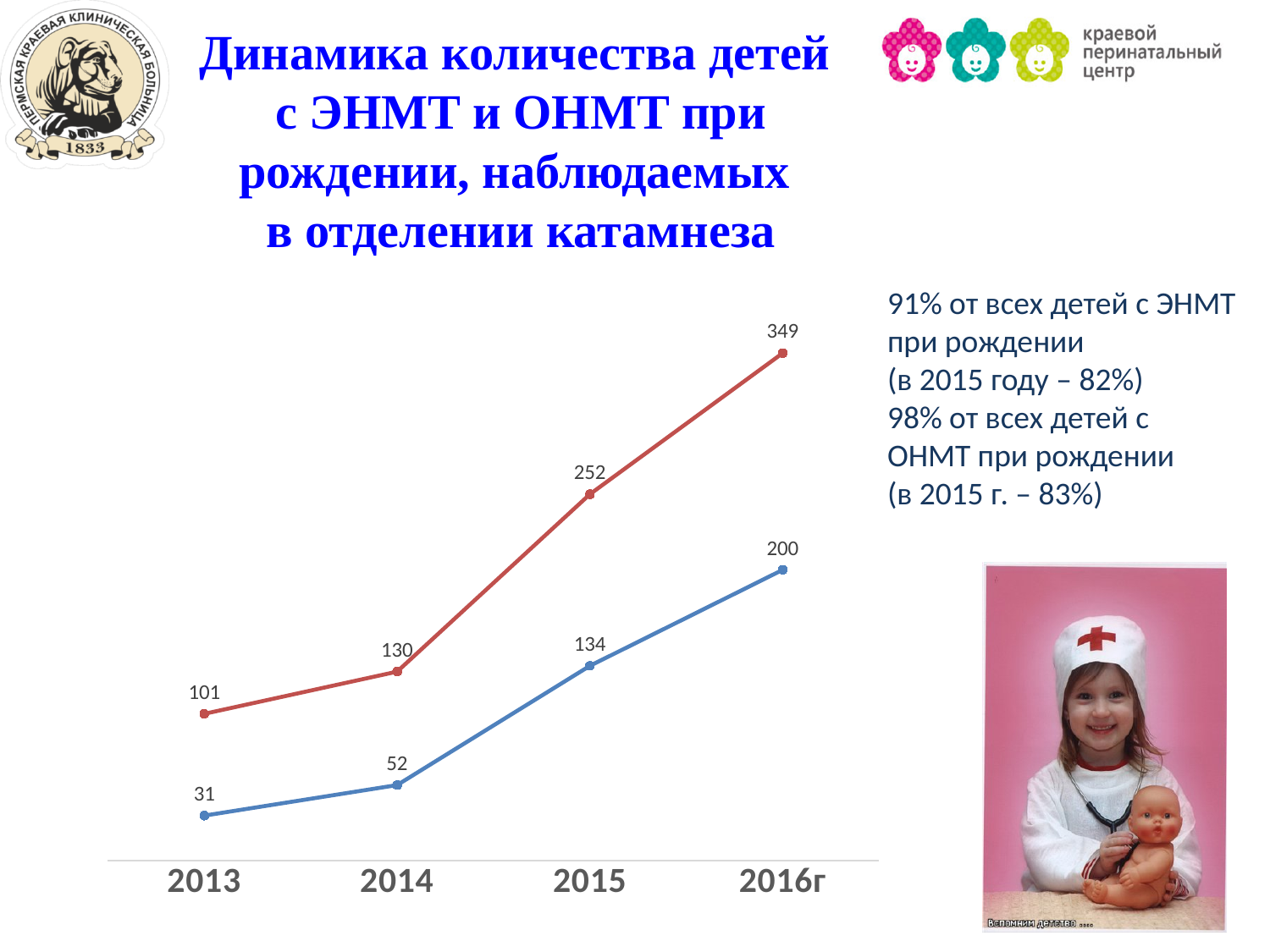
What is the value of the red line in 2016г? 349 By how much did the red line value increase from 2013 to 2016г? 248 What is the value of the blue line in 2013? 31 What is the value of the red line in 2015? 252 What is the difference between the red line and the blue line values in 2015? 118 What is the value of the blue line in 2014? 52 Which is larger in 2014: the red line value or the blue line value? the red line value How many years are shown on the x axis of the chart? 4 What type of chart is shown on the slide? line chart In which year does the red line have its lowest value? 2013 Do the values of the blue line rise or fall from 2013 to 2016г? rise In which year does the blue line reach its highest value? 2016г